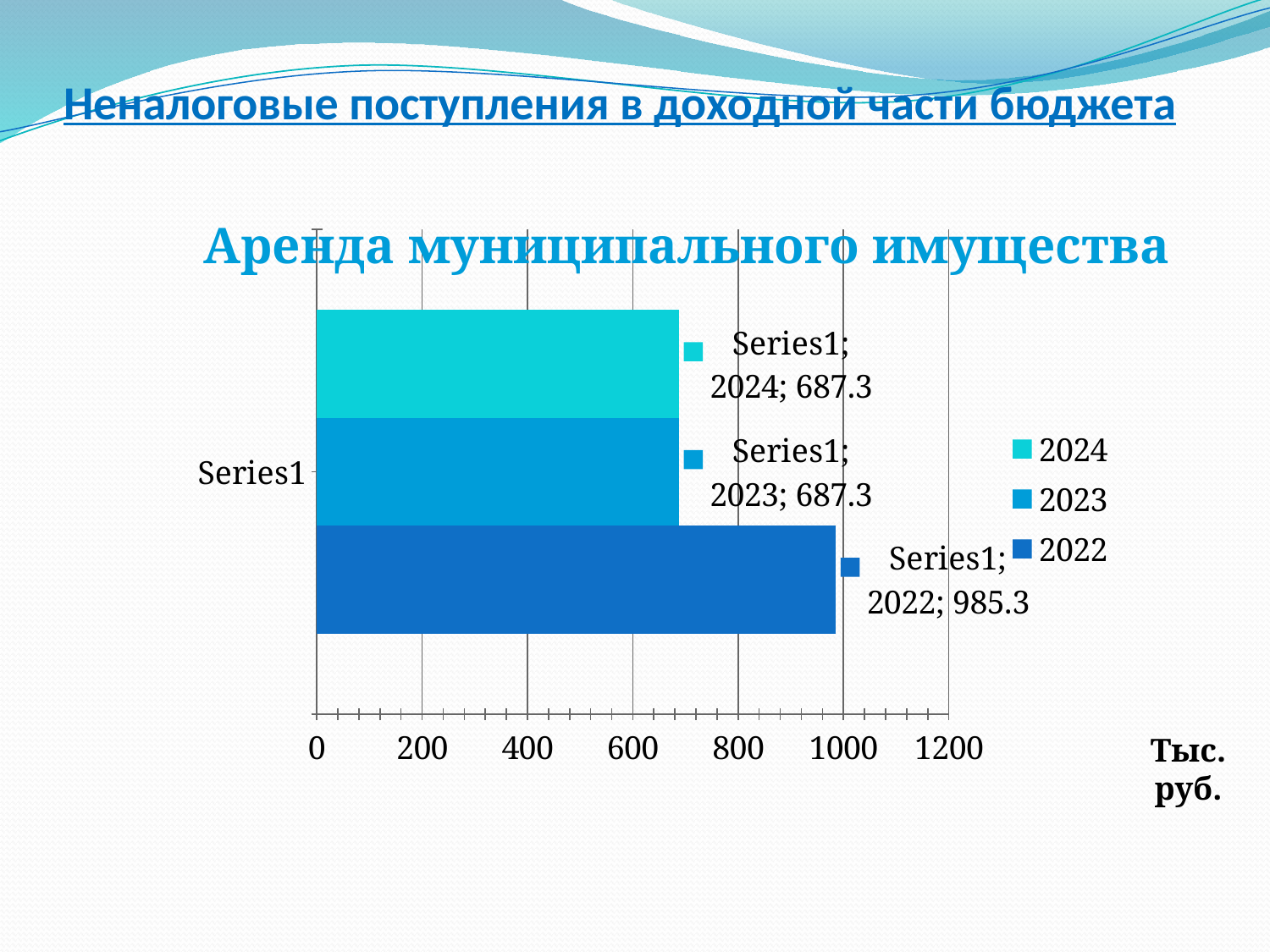
Is the value for 2024 greater or less than 800? less What is the value for 2024 in the chart? 687.3 What kind of chart is shown on the slide? bar chart Which is larger, the value for 2022 or the value for 2024? 2022 What unit is shown next to the x axis of the chart? Тыс. руб. What is the value for 2022 in the chart? 985.3 Is the value for 2022 greater or less than 800? greater What is the value for 2023 in the chart? 687.3 What is the difference between the values for 2022 and 2023? 298 What is the title of the chart? Аренда муниципального имущества Which year has the highest value in the chart? 2022 How many series does the legend list? 3